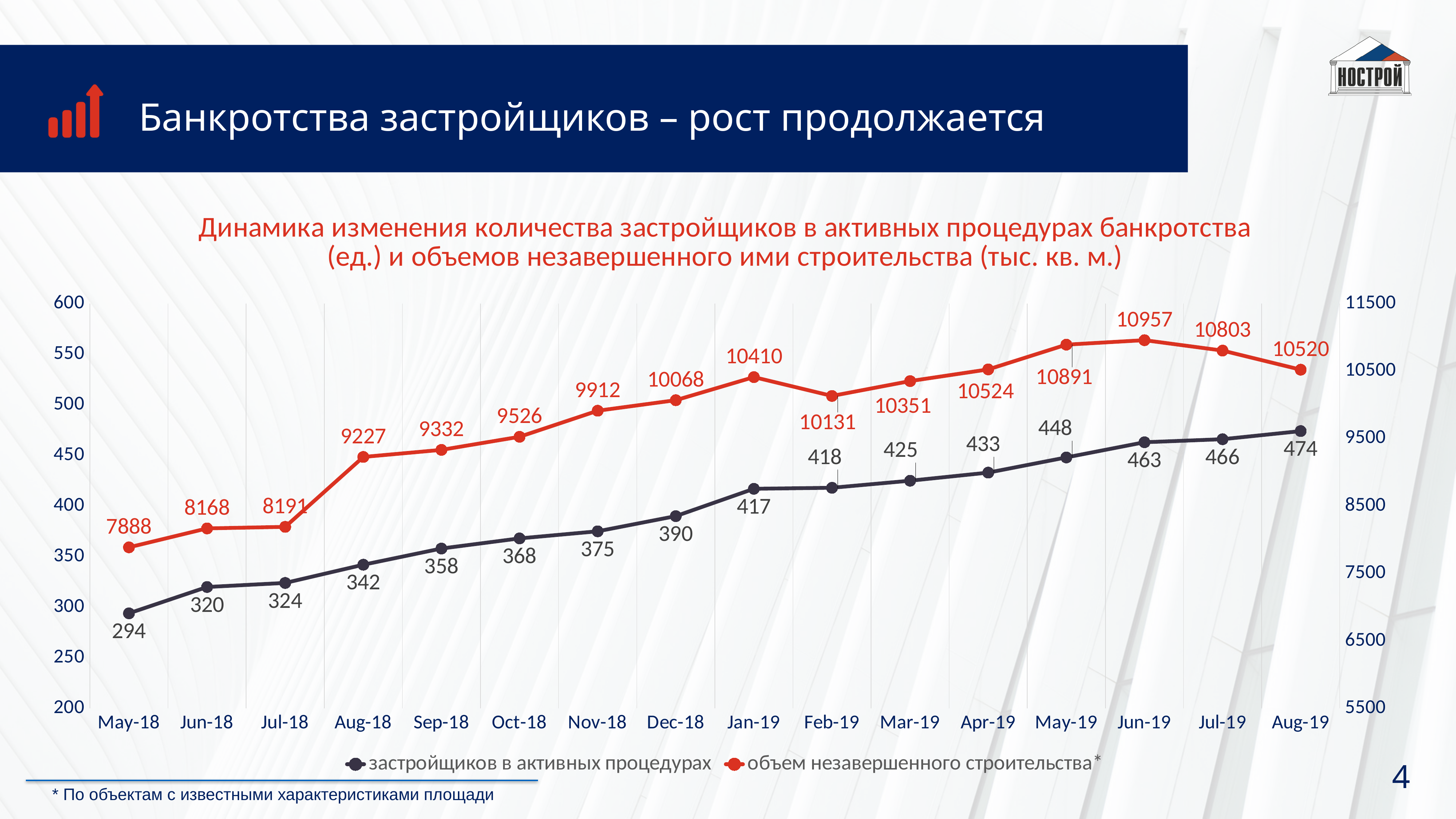
What is the value of the 'застройщиков в активных процедурах' series for Jan-19? 417 In which month does the 'объем незавершенного строительства*' series reach its highest value? Jun-19 What is the value of the 'объем незавершенного строительства*' series for Feb-19? 10131 In which month is the 'застройщиков в активных процедурах' series at its lowest? May-18 What kind of chart is shown on the slide? line chart Which is larger for the 'объем незавершенного строительства*' series: Jan-19 or Feb-19? Jan-19 How many series does the legend list? 2 What is the difference between the 'застройщиков в активных процедурах' values for Aug-19 and May-18? 180 How many months are plotted on the x axis? 16 What is the difference between the 'объем незавершенного строительства*' values for Jun-19 and Jul-19? 154 What colour is the line for 'объем незавершенного строительства*'? red Does the 'застройщиков в активных процедурах' series rise or fall from May-18 to Aug-19? rise